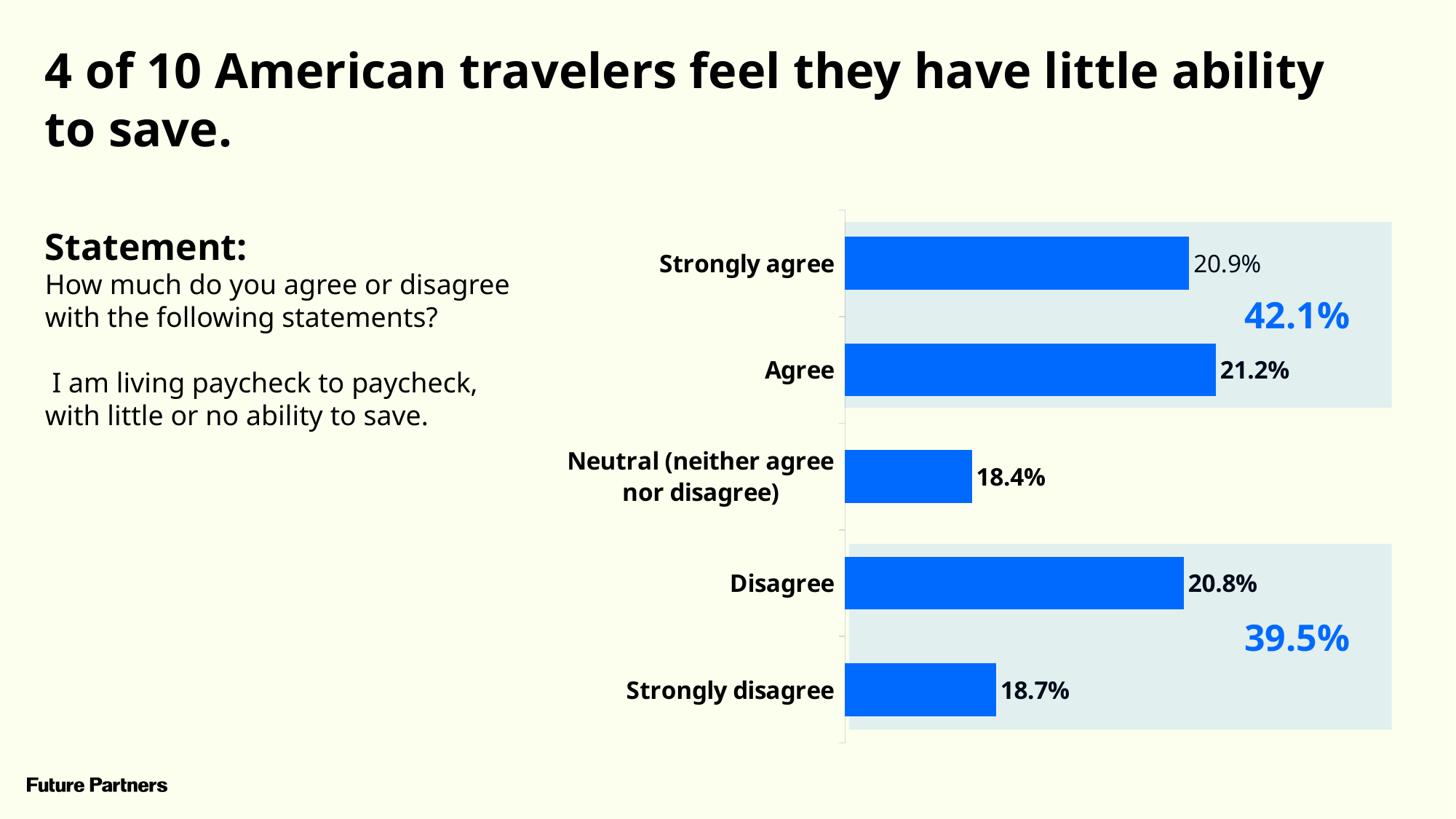
What percentage of respondents chose Strongly disagree? 18.7% What is the difference between the Agree and Strongly disagree percentages? 2.5% Which response category has the lowest percentage? Neutral (neither agree nor disagree) What type of chart is shown on the slide? Bar chart What percentage of respondents chose Agree? 21.2% What combined percentage is shown for Strongly agree and Agree together? 42.1% How many response categories are shown in the chart? 5 What percentage of respondents strongly agree with the statement? 20.9% What combined percentage is shown for Disagree and Strongly disagree together? 39.5% Which is larger, the value for Disagree or the value for Strongly disagree? Disagree What is the value for Neutral (neither agree nor disagree)? 18.4% Which response category has the highest percentage? Agree